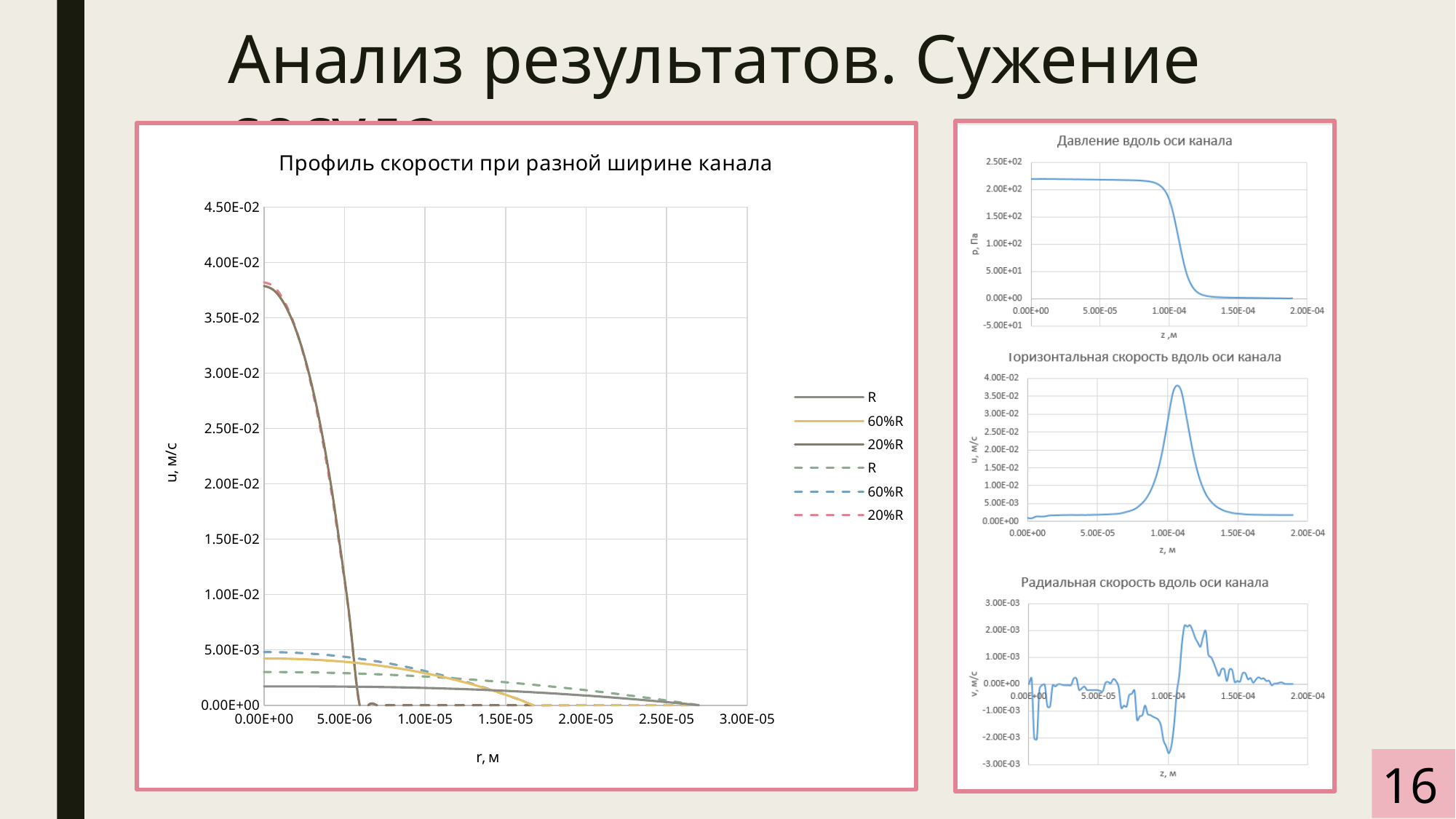
What kind of chart is 'Профиль скорости при разной ширине канала'? line chart What is the y-axis label of 'Давление вдоль оси канала'? p, Па What is the x-axis label of 'Профиль скорости при разной ширине канала'? r, м In 'Давление вдоль оси канала', is the value at z = 0.00E+00 greater or less than 2.00E+02? greater In 'Радиальная скорость вдоль оси канала', is the lowest value greater or less than -2.00E-03? less In 'Горизонтальная скорость вдоль оси канала', is the value at z = 0.00E+00 greater or less than 5.00E-03? less How many series does the legend of 'Профиль скорости при разной ширине канала' list? 6 In 'Давление вдоль оси канала', do the values rise or fall along the z axis? fall